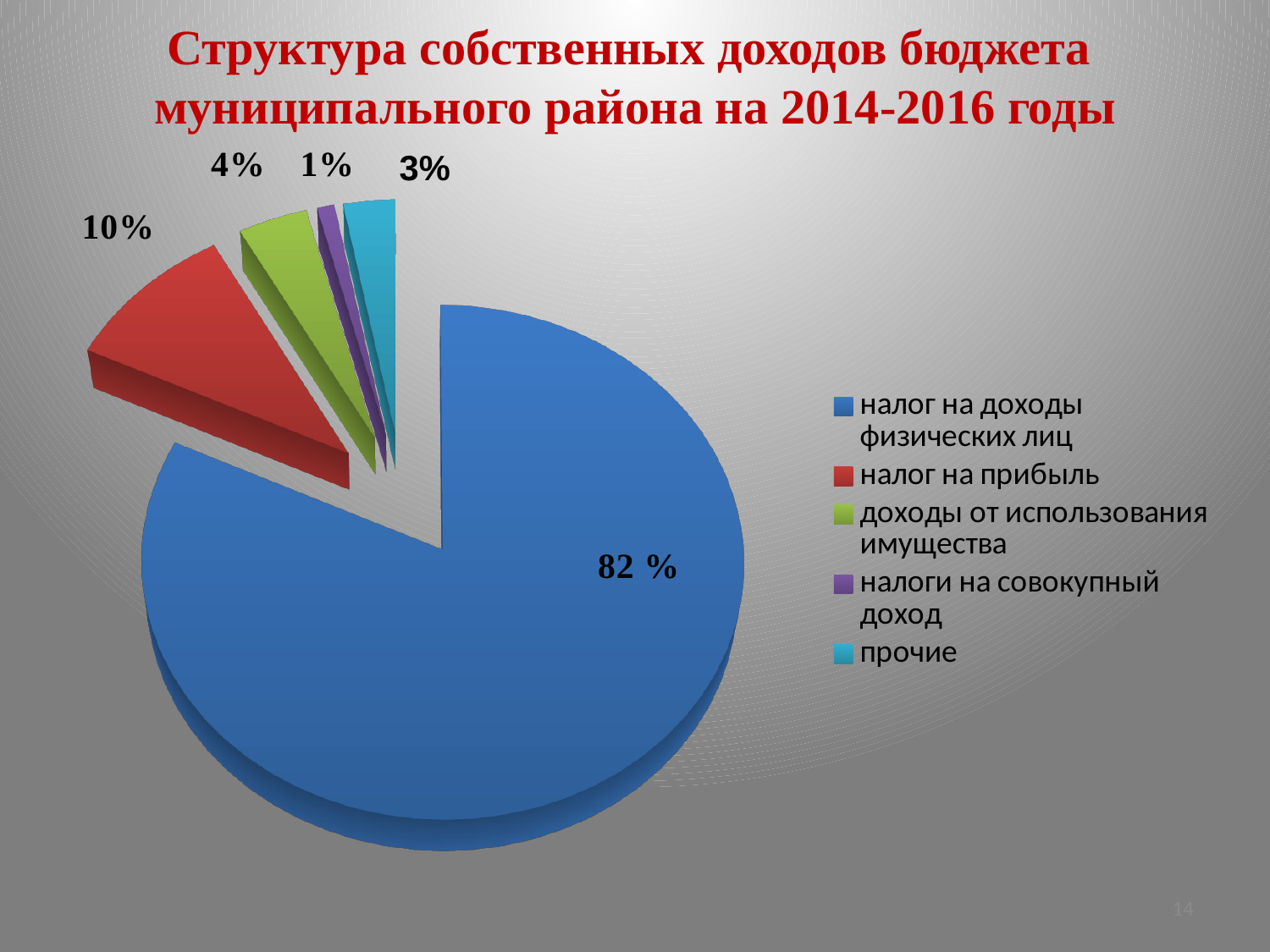
Which is larger, the share for доходы от использования имущества or the share for прочие? доходы от использования имущества What kind of chart is shown on the slide? pie chart What share of the pie does налоги на совокупный доход have? 1% Which category has the smallest slice of the pie? налоги на совокупный доход What is the difference in percentage points between налог на прибыль and прочие? 7 What share of the pie does прочие have? 3% Which category has the largest slice of the pie? налог на доходы физических лиц What share of the pie does доходы от использования имущества have? 4% How many categories does the pie chart show? 5 What colour is the slice for налог на прибыль? red